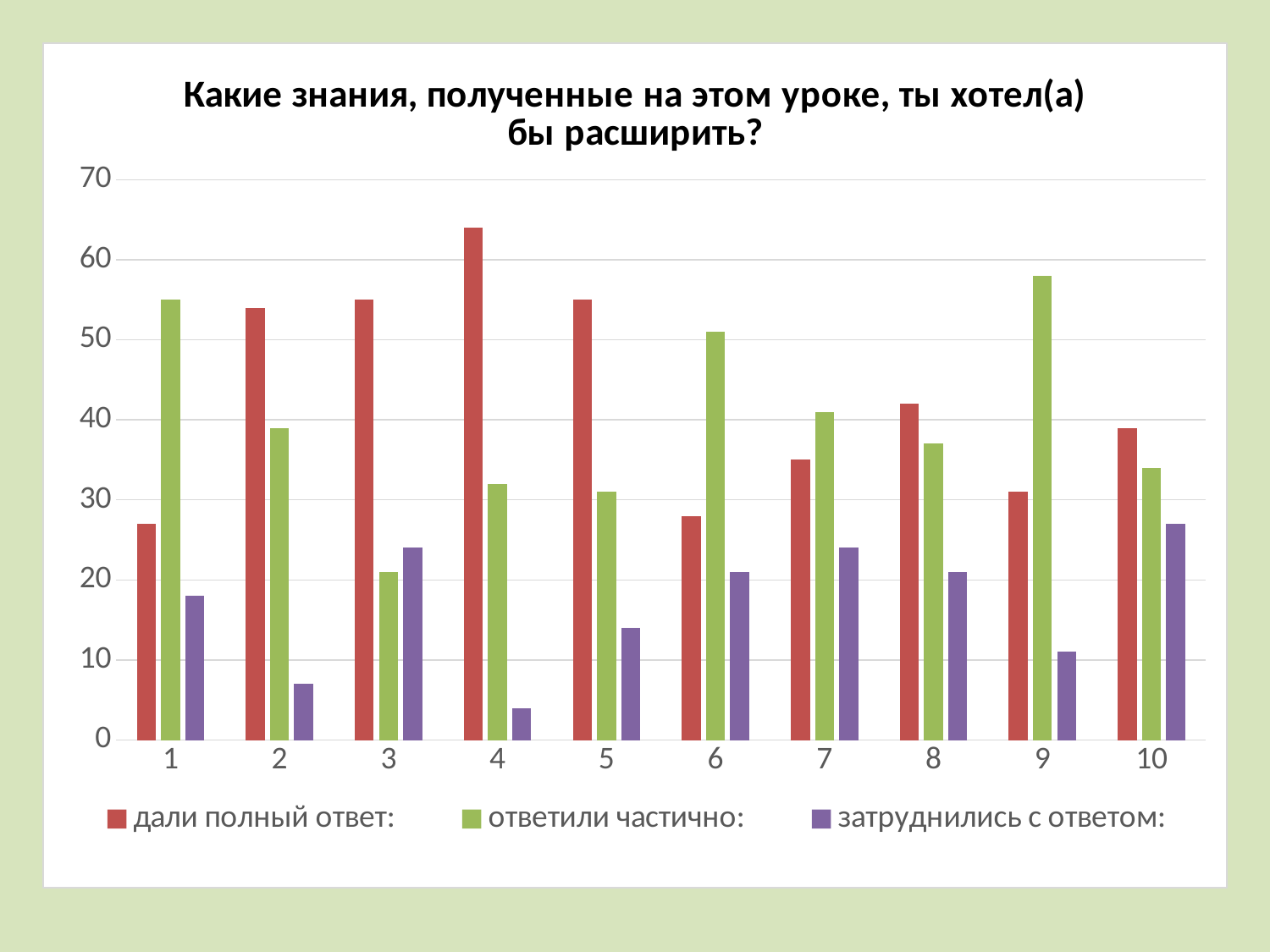
What kind of chart is shown on the slide? bar chart Is the value of "затруднились с ответом:" for category 2 greater or less than 10? less For category 1, which is larger: "дали полный ответ:" or "ответили частично:"? ответили частично: For which category is the value of "затруднились с ответом:" the lowest? 4 How many categories are shown along the x axis? 10 For which category is the value of "дали полный ответ:" the highest? 4 Is the value of "затруднились с ответом:" for category 4 greater or less than 10? less For category 4, which is larger: "дали полный ответ:" or "ответили частично:"? дали полный ответ: Is the value of "дали полный ответ:" for category 4 greater or less than 60? greater How many series does the legend list? 3 Which colour represents the series "затруднились с ответом:" in the legend? purple